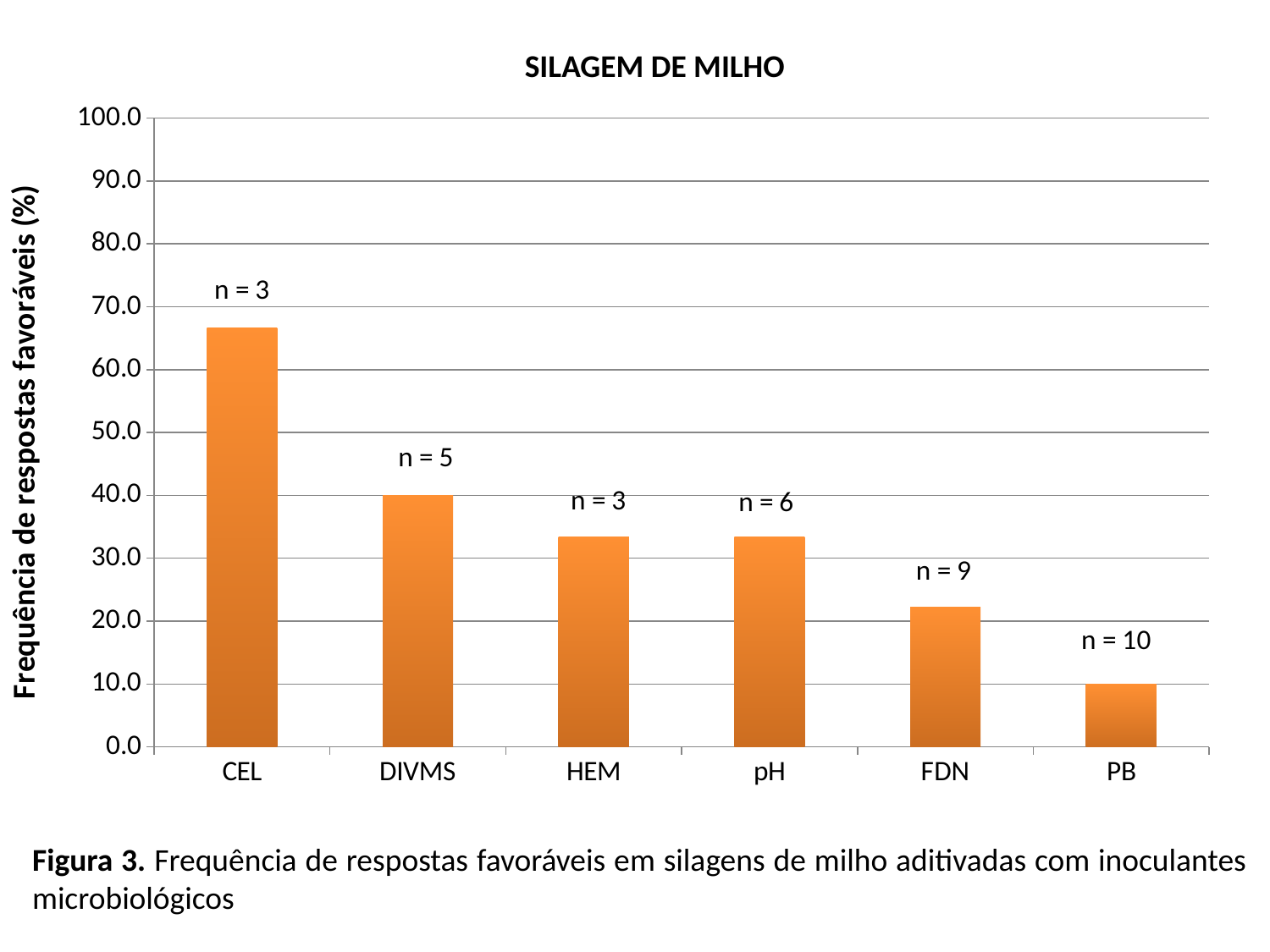
How many categories are shown on the x axis of the chart? 6 Is the value for FDN greater or less than 30? less What is the difference between the values for DIVMS and PB? 30.0 Which is larger, the value for CEL or the value for DIVMS? CEL What kind of chart is shown on the slide? bar chart Is the value for CEL greater or less than 60? greater Do the values rise or fall from left to right along the x axis? fall What is the frequency of favourable responses (%) for PB? 10.0 What is the title of the chart? SILAGEM DE MILHO Which category has the lowest frequency of favourable responses? PB Which category has the highest frequency of favourable responses? CEL What is the frequency of favourable responses (%) for DIVMS? 40.0